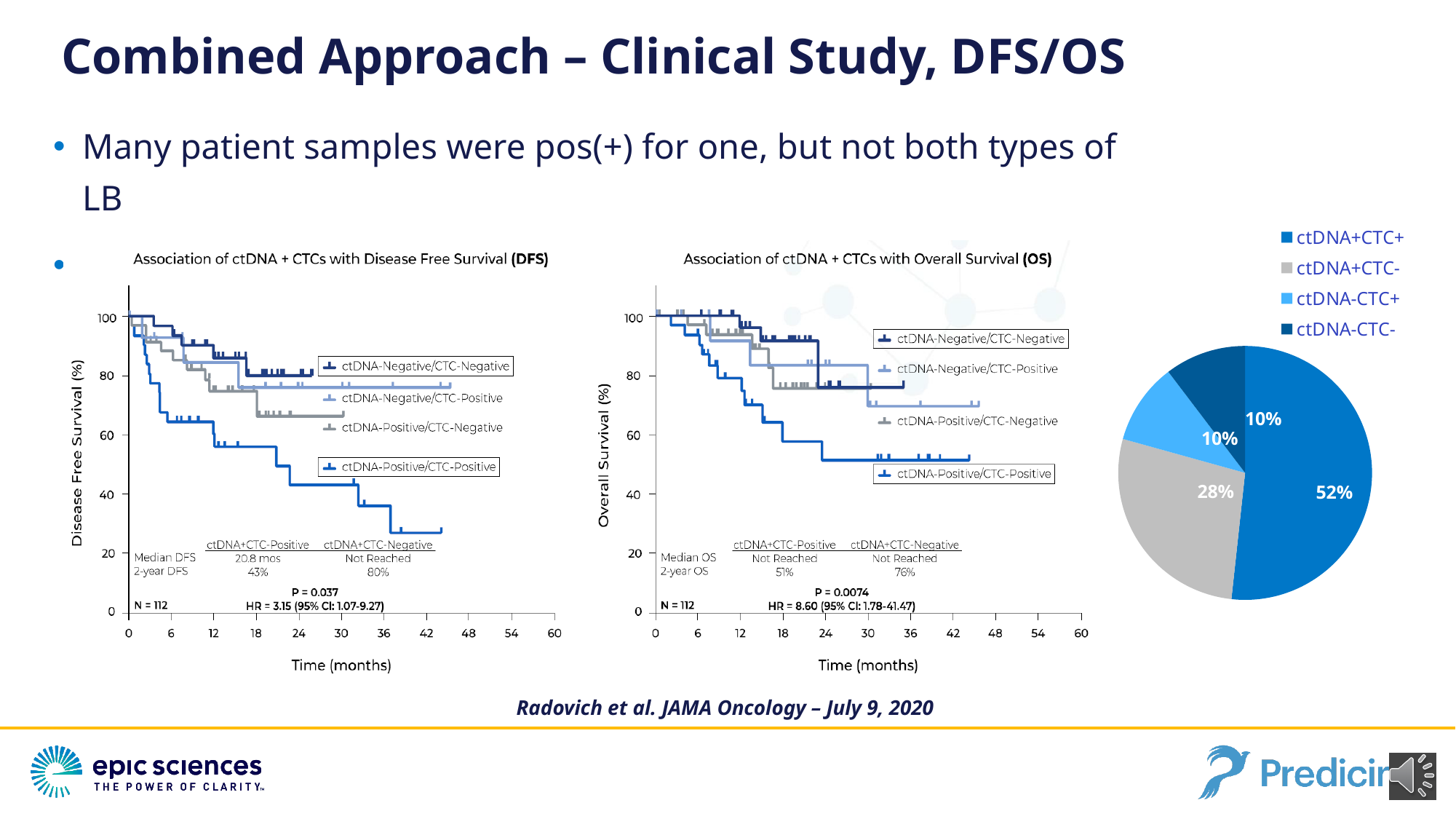
In the OS chart, what is the 2-year OS for the ctDNA+CTC-Negative group? 76% How many entries does the pie chart legend list? 4 In the pie chart, what share of patients were ctDNA+CTC-? 28% In the pie chart, what share of patients were ctDNA+CTC+? 52% In the pie chart, which category has the largest slice? ctDNA+CTC+ How many slices does the pie chart have? 4 In the DFS chart, what is the 2-year DFS for the ctDNA+CTC-Positive group? 43% In the DFS chart, does the ctDNA-Positive/CTC-Positive curve rise or fall over time? fall In the pie chart, what is the difference between the ctDNA+CTC+ share and the ctDNA+CTC- share? 24% In the DFS chart, what is the median DFS for the ctDNA+CTC-Positive group? 20.8 mos In the OS chart, what is the hazard ratio (HR) shown? 8.60 In the pie chart, what is the combined share of the ctDNA-CTC+ and ctDNA-CTC- slices? 20%